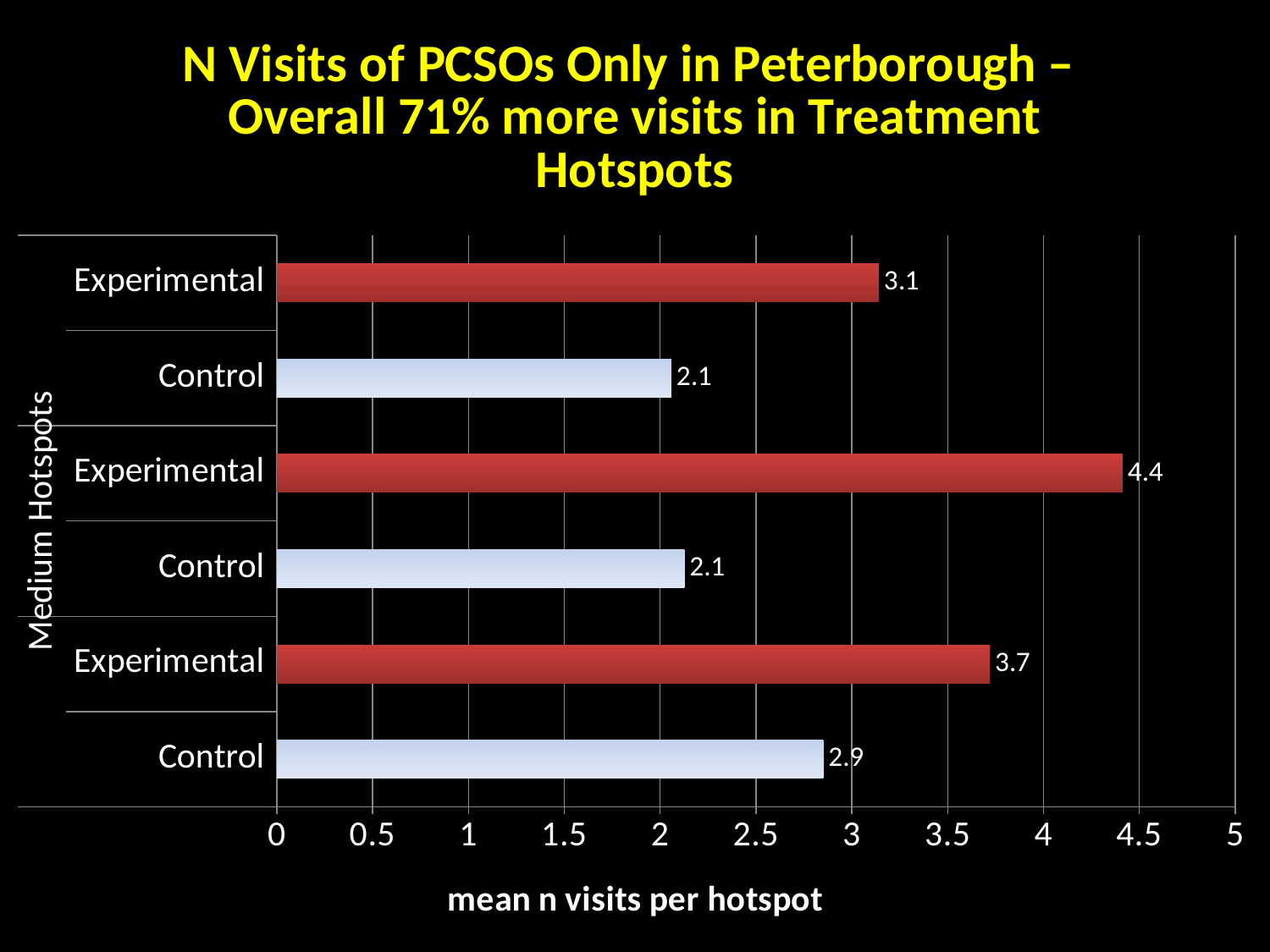
Is the value of the longest bar greater or less than 4? greater What colour are the Experimental bars? red What is the difference between the longest Experimental bar (4.4) and the Control bar directly below it (2.1)? 2.3 What is the value of the bottommost Control bar? 2.9 What is the difference between the bottom Experimental bar (3.7) and the bottom Control bar (2.9)? 0.8 What is the value of the topmost Experimental bar? 3.1 Which is larger: the topmost Experimental bar or the topmost Control bar? the topmost Experimental bar What is the label of the horizontal axis? mean n visits per hotspot What type of chart is shown on the slide? bar chart What is the value of the shortest bar in the chart? 2.1 How many bars are plotted in the chart? 6 What is the value of the longest bar in the chart? 4.4